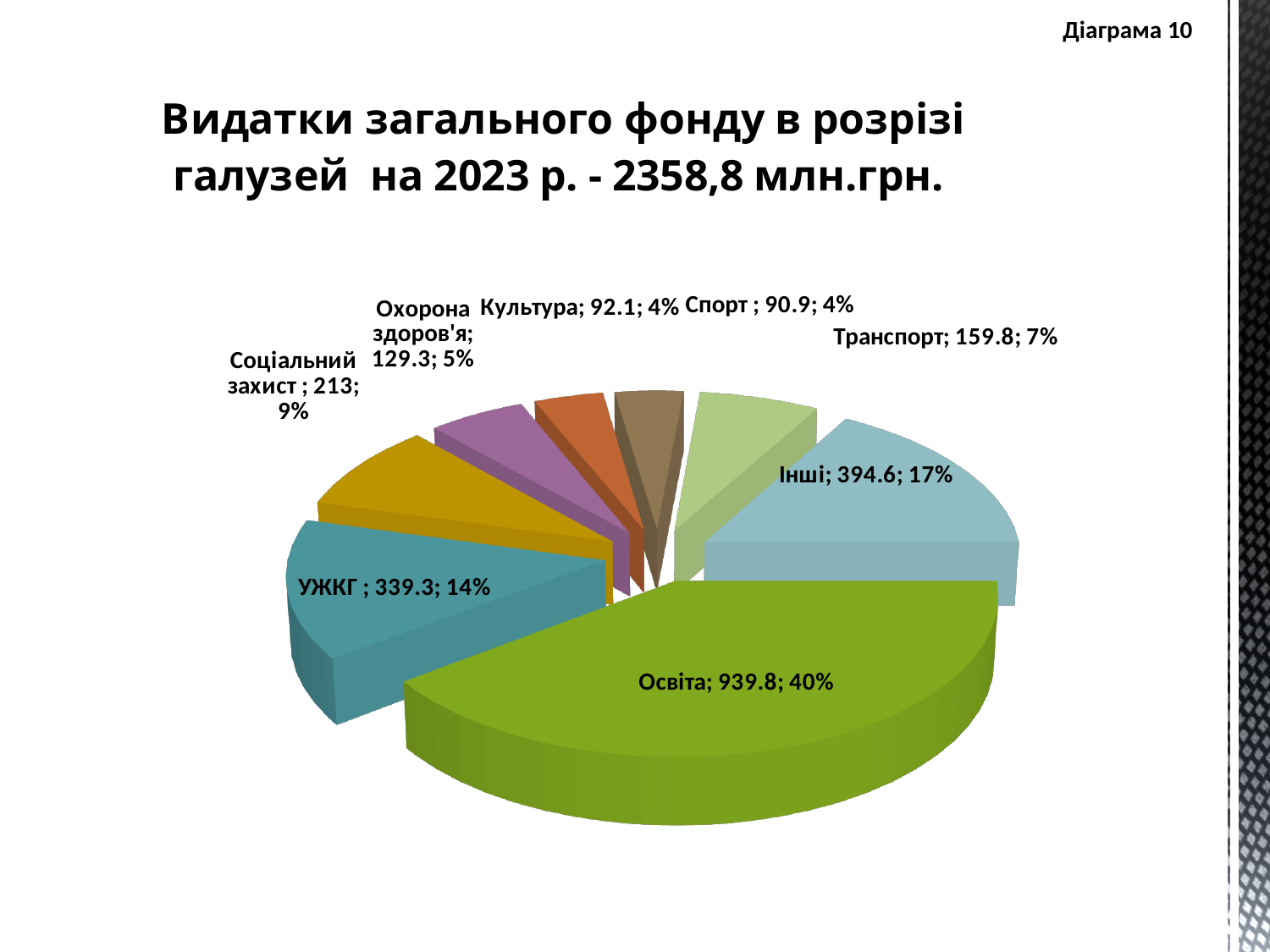
Which category has the smallest slice? Спорт What share of the pie does Освіта take? 40% What is the value for Транспорт? 159.8 Which category has the largest slice? Освіта How many slices does the pie chart have? 8 What kind of chart is shown on the slide? pie chart What is the difference between the values for Освіта and Інші? 545.2 What is the value for Освіта? 939.8 Which is larger, the value for Соціальний захист or the value for Охорона здоров'я? Соціальний захист What is the value for УЖКГ? 339.3 What total amount is stated in the chart title for 2023? 2358,8 млн.грн. What share of the pie does Інші take? 17%